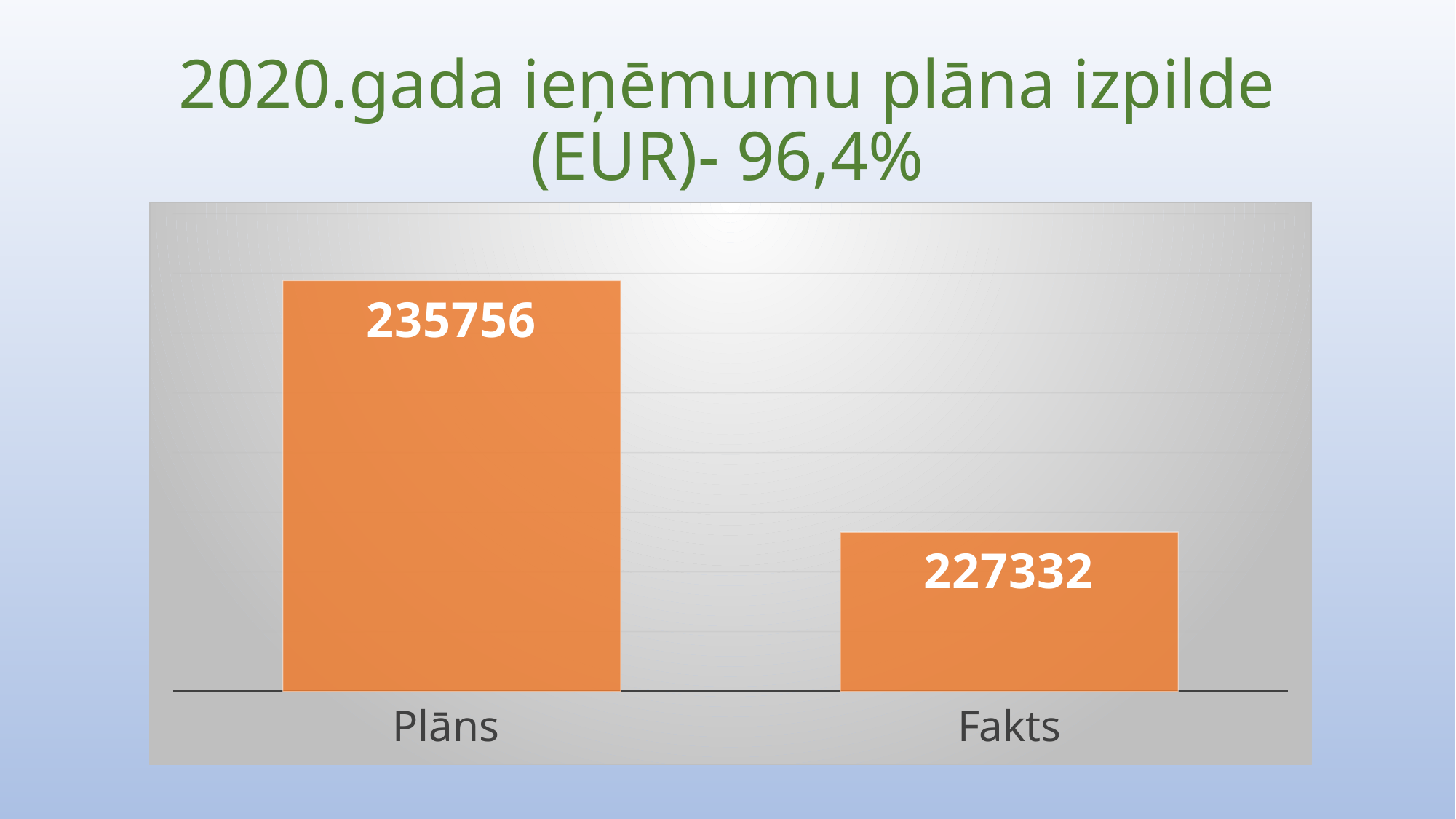
Which category has the highest value? Plāns Which is larger, the value for Plāns or the value for Fakts? Plāns What kind of chart is shown on the slide? bar chart Do the values rise or fall from Plāns to Fakts? fall What colour are the bars in the chart? orange Which category has the lowest value? Fakts What is the value for Fakts? 227332 What is the title of the slide? 2020.gada ieņēmumu plāna izpilde (EUR)- 96,4% How many categories are shown in the chart? 2 What is the difference between the values for Plāns and Fakts? 8424 What is the value for Plāns? 235756